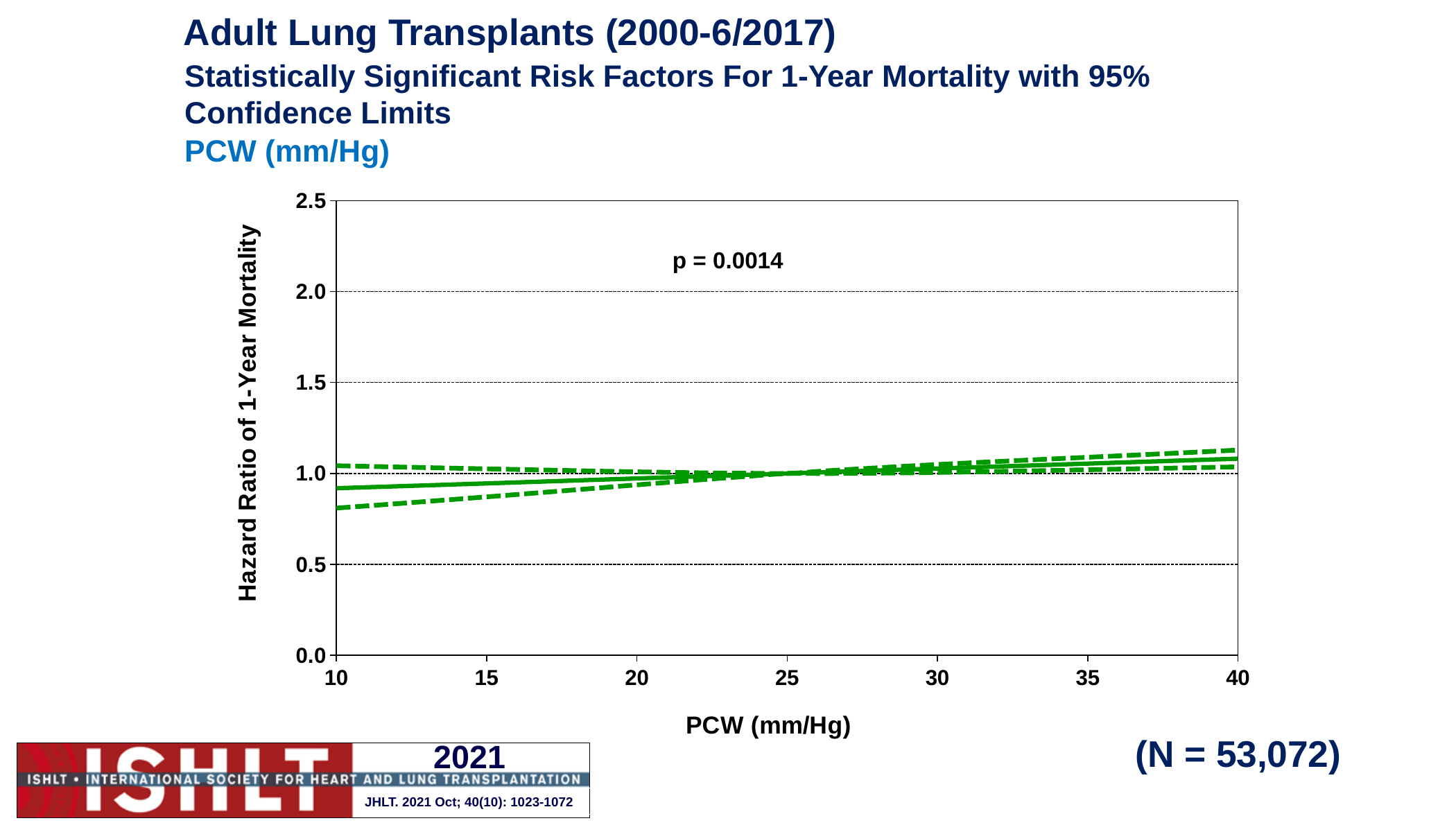
What is the sample size (N) shown on the slide? N = 53,072 What is the highest value shown on the y axis of the chart? 2.5 Is the hazard ratio (solid line) at a PCW of 10 mm/Hg greater or less than 0.5? greater Does the hazard ratio of 1-year mortality rise or fall as PCW increases from 10 to 40 mm/Hg? rise What kind of chart is shown on the slide? line chart Is the hazard ratio (solid line) at a PCW of 40 mm/Hg greater or less than 1.0? greater Is the lower 95% confidence limit (lower dashed line) at a PCW of 10 mm/Hg greater or less than 1.0? less How many lines are plotted on the chart? 3 What p-value is printed on the chart? p = 0.0014